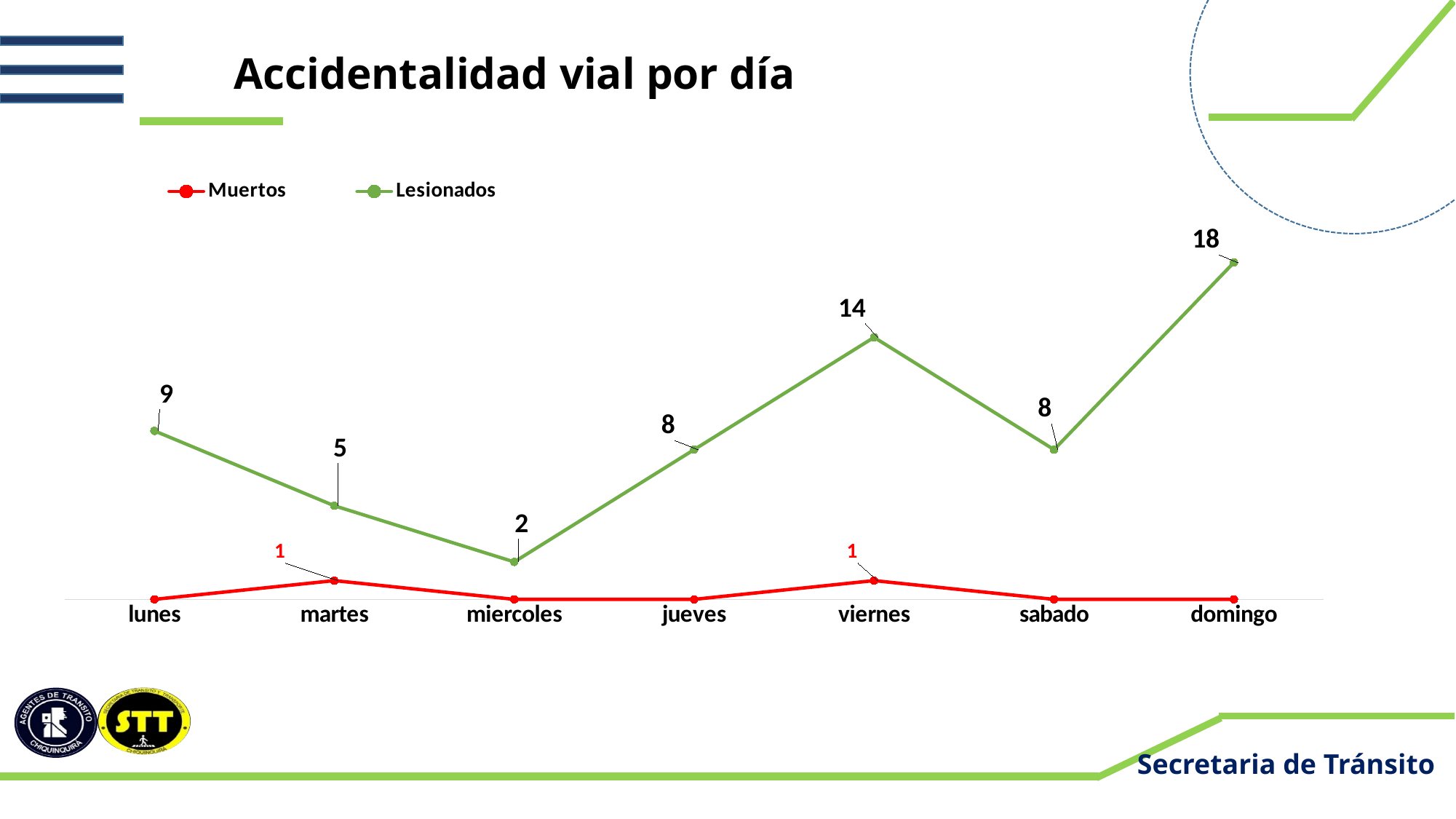
What is the value for Lesionados on miercoles? 2 How many series does the legend list? 2 Do the Lesionados values rise or fall from lunes to miercoles? fall On which day is the Lesionados value lowest? miercoles What kind of chart is shown? line chart What is the value for Muertos on martes? 1 Which is larger, Lesionados on lunes or Lesionados on jueves? lunes What is the value for Lesionados on domingo? 18 How many days are shown on the x axis? 7 What is the difference between Lesionados on domingo and on viernes? 4 What is the title of the chart? Accidentalidad vial por día On which day is the Lesionados value highest? domingo